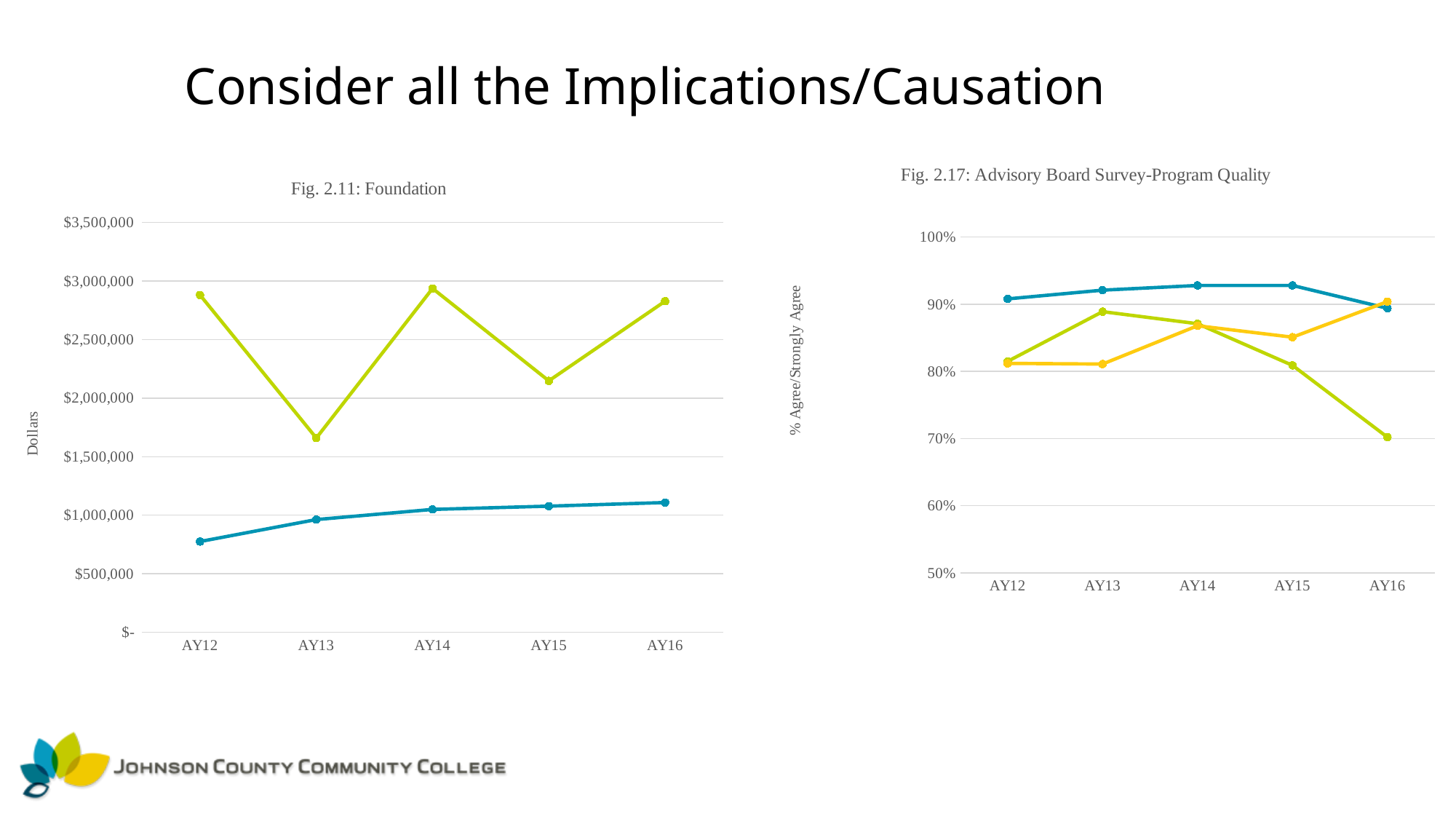
What is the y-axis label of Fig. 2.17: Advisory Board Survey-Program Quality? % Agree/Strongly Agree In Fig. 2.11: Foundation, is the blue line's value for AY12 greater or less than $1,000,000? less What kind of chart is Fig. 2.11: Foundation? line chart In Fig. 2.17: Advisory Board Survey-Program Quality, is the green line's value for AY16 greater or less than 80%? less How many academic years are shown on the x axis of Fig. 2.11: Foundation? 5 In Fig. 2.11: Foundation, which line has the higher value in AY16, the green line or the blue line? the green line What is the y-axis label of Fig. 2.11: Foundation? Dollars In Fig. 2.11: Foundation, is the green line's value for AY13 greater or less than $2,000,000? less In Fig. 2.11: Foundation, in which academic year is the green line at its lowest? AY13 In Fig. 2.17: Advisory Board Survey-Program Quality, which line has the higher value in AY15, the blue line or the yellow line? the blue line In Fig. 2.17: Advisory Board Survey-Program Quality, in which academic year is the green line at its lowest? AY16 In Fig. 2.11: Foundation, does the blue line rise or fall from AY12 to AY16? rise